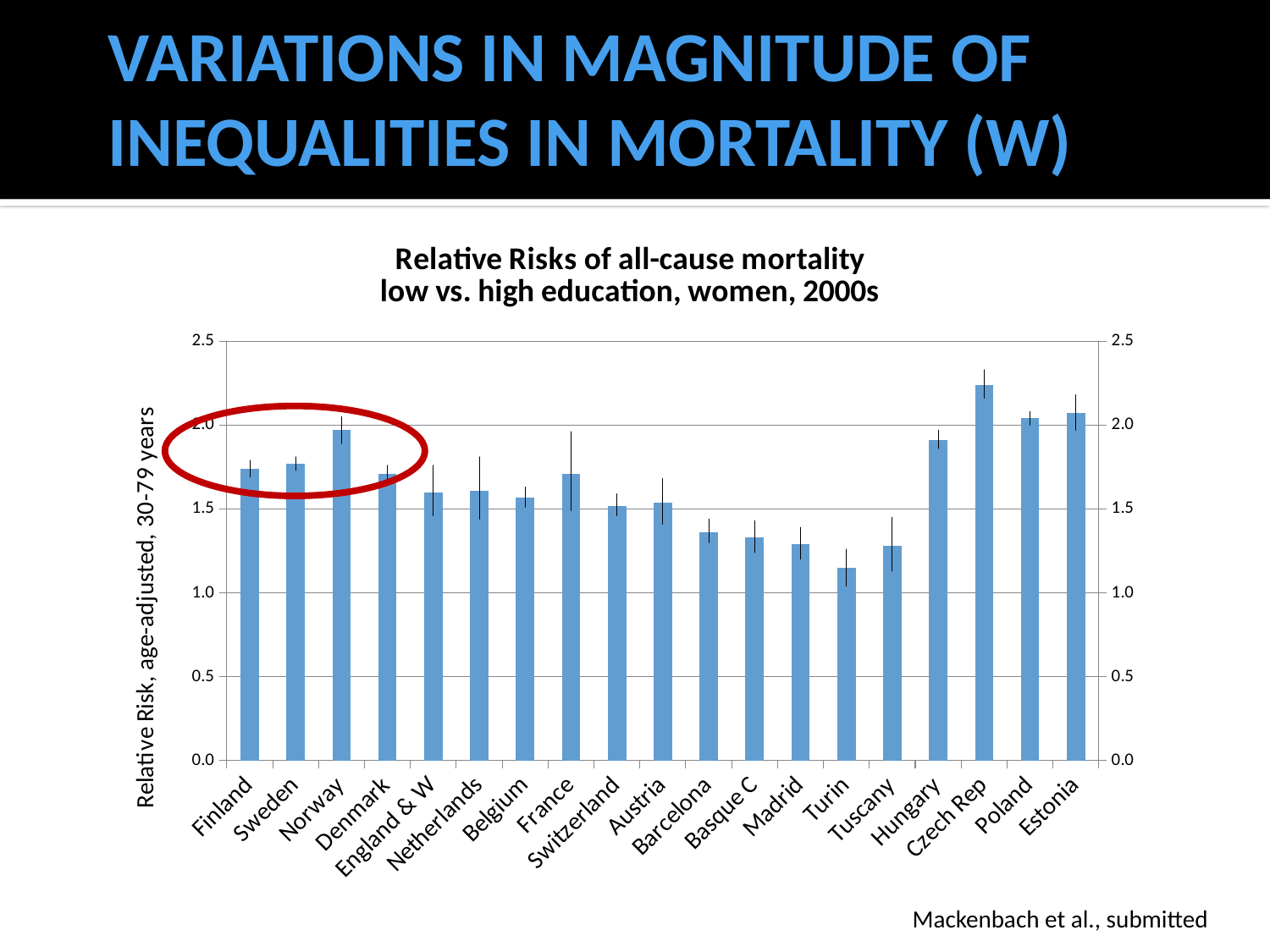
What is the label of the vertical axis of the chart? Relative Risk, age-adjusted, 30-79 years Is the value for Barcelona greater or less than 1.5? less Is the value for Hungary greater or less than 2.0? less Which has the larger relative risk, Norway or Finland? Norway How many countries or regions are shown on the x axis of the chart? 19 Which country or region has the lowest relative risk in the chart? Turin What kind of chart is shown on the slide? bar chart Is the value for Czech Rep greater or less than 2.0? greater Which has the larger relative risk, Turin or Hungary? Hungary What is the title of the chart? Relative Risks of all-cause mortality low vs. high education, women, 2000s Which country or region has the highest relative risk in the chart? Czech Rep